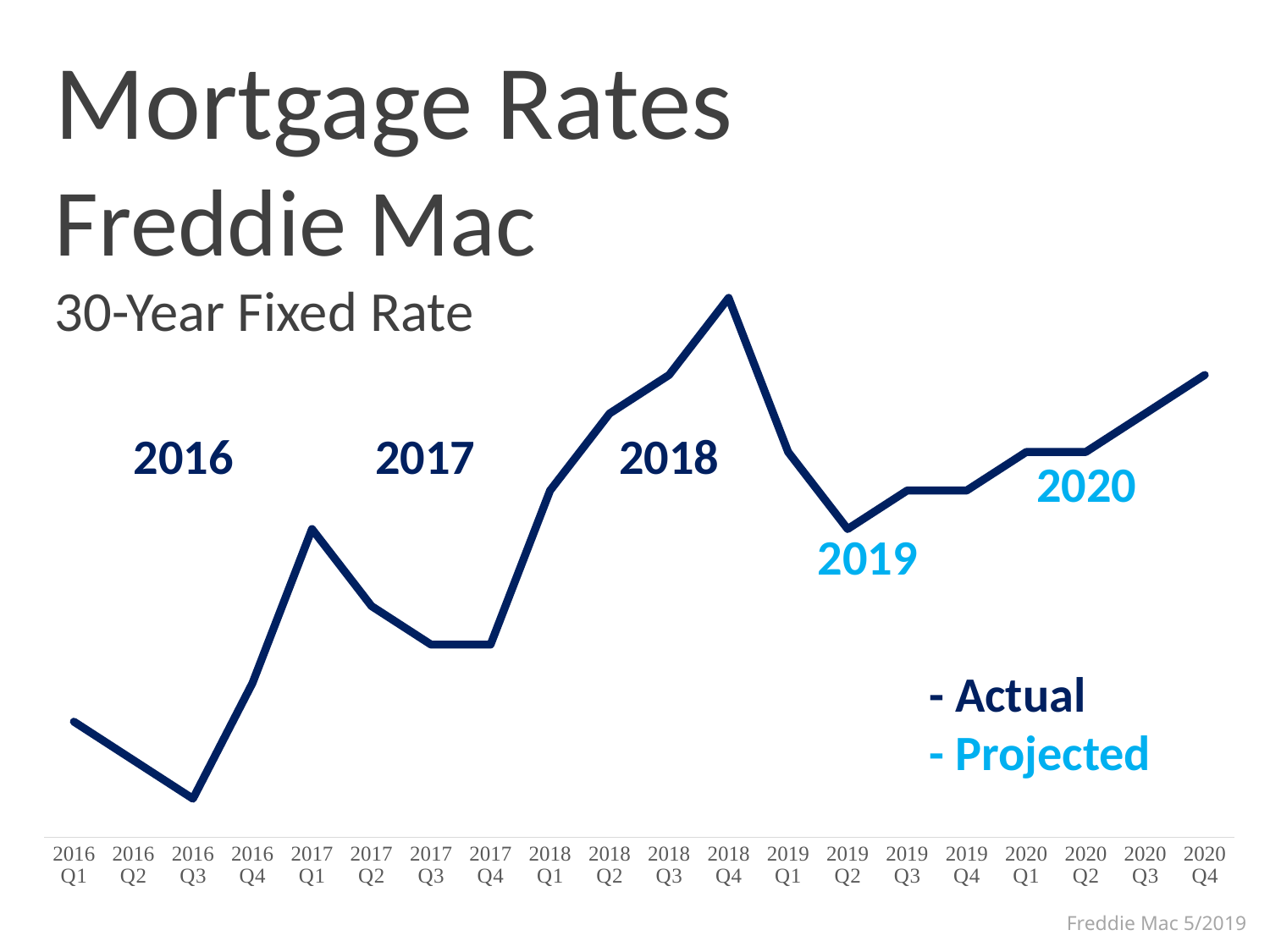
Which is higher, the rate in 2018 Q4 or the rate in 2019 Q2? 2018 Q4 Do the rates rise or fall from 2017 Q4 to 2018 Q4? rise Which quarter has the lowest mortgage rate on the chart? 2016 Q3 Which quarter has the highest mortgage rate on the chart? 2018 Q4 What kind of chart is shown on the slide? line chart What rate product does the chart subtitle say is plotted? 30-Year Fixed Rate Which is higher, the rate in 2016 Q1 or the rate in 2020 Q4? 2020 Q4 Do the rates rise or fall from 2019 Q2 to 2020 Q4? rise Which is higher, the rate in 2017 Q1 or the rate in 2017 Q4? 2017 Q1 Do the rates rise or fall from 2018 Q4 to 2019 Q2? fall What does the light blue portion of the line represent according to the legend? Projected How many quarterly points are plotted along the x axis? 20